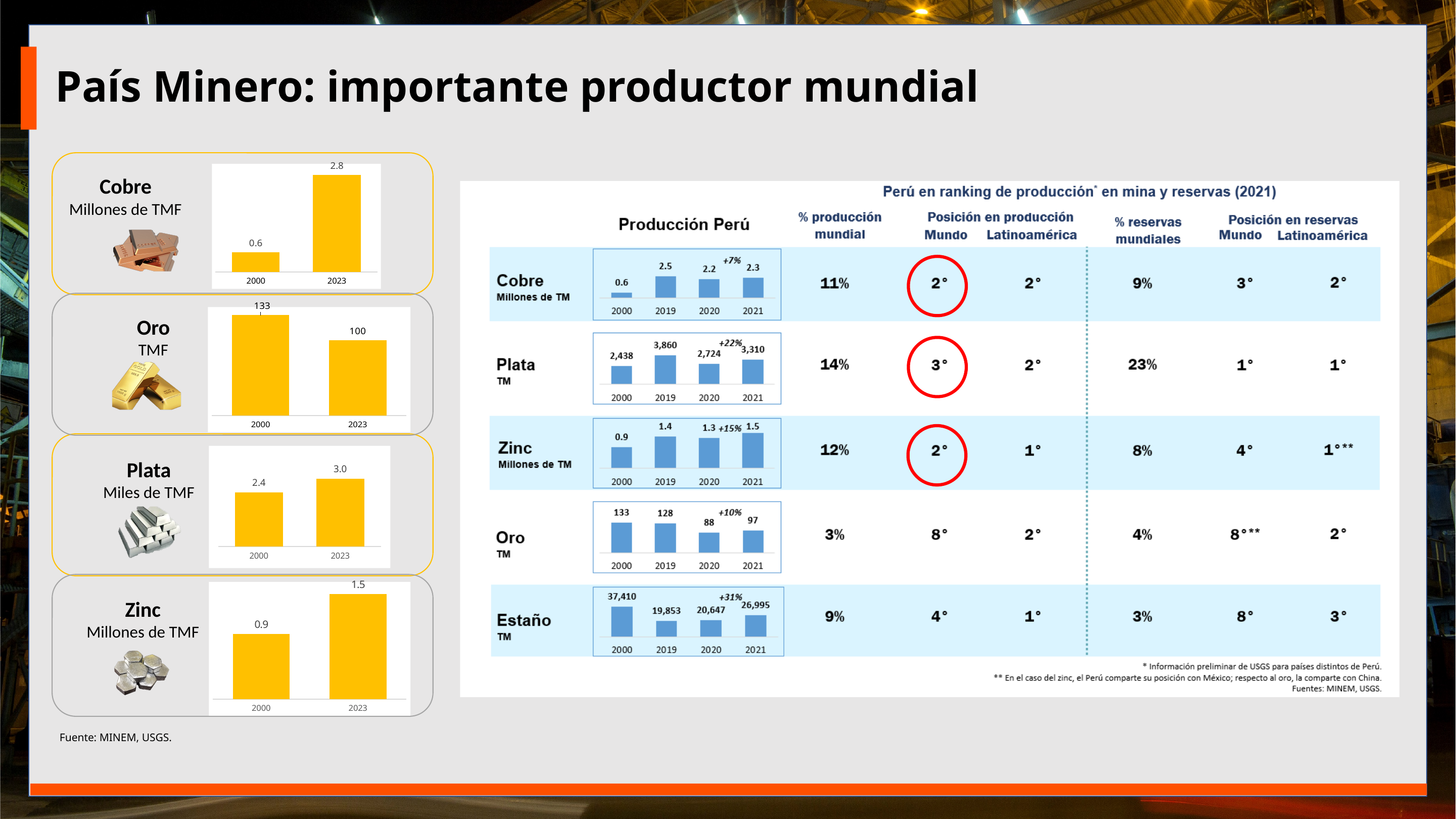
In the Oro chart on the left, do the values rise or fall from 2000 to 2023? fall In the Zinc chart on the left, what is the value for 2000? 0.9 In the Cobre chart on the left, what is the difference between the 2023 and 2000 values? 2.2 In the Zinc chart on the left, which year has the higher value, 2000 or 2023? 2023 In the Estaño mini chart in the right-hand table, which year has the highest value? 2000 In the Oro chart on the left, what is the value for 2000? 133 How many years are shown in the Cobre chart on the left? 2 In the Cobre chart on the left, what is the value for 2023? 2.8 In the Plata mini chart in the right-hand table, what is the value for 2019? 3,860 In the Oro mini chart in the right-hand table, what is the value for 2020? 88 In the Plata chart on the left, what is the value for 2023? 3.0 What kind of chart is the Plata chart on the left? bar chart